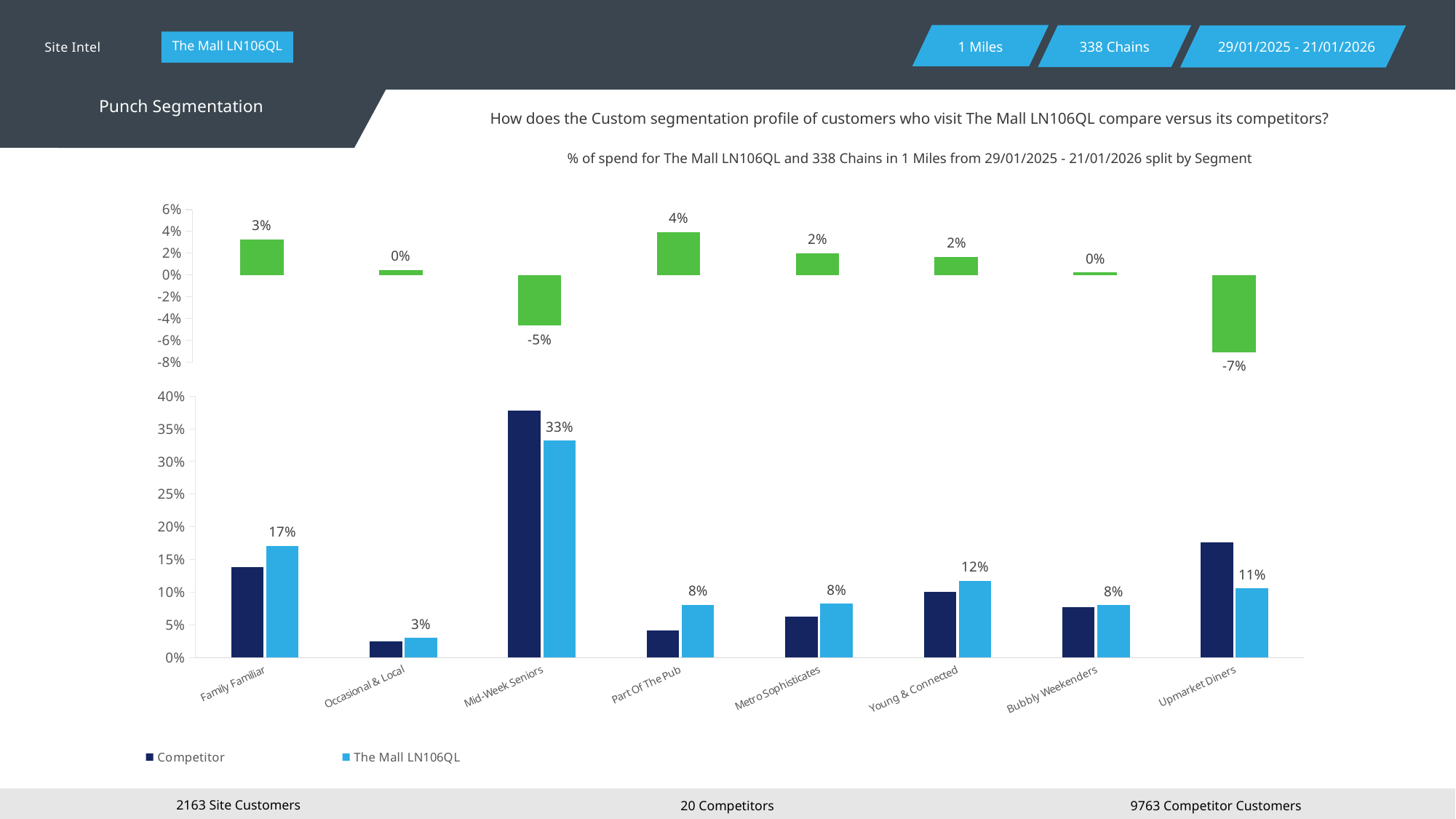
In the bottom chart, what is the difference between The Mall LN106QL values for Family Familiar and Occasional & Local? 14% What kind of chart is the bottom chart? Bar chart In the top chart, which segment has the lowest value? Upmarket Diners In the bottom chart, which segment has the highest value for The Mall LN106QL? Mid-Week Seniors How many segments are shown on the x axis of the bottom chart? 8 In the bottom chart, what is the value for The Mall LN106QL in the Young & Connected segment? 12% In the top chart, what is the value for Upmarket Diners? -7% In the bottom chart, what is the value for The Mall LN106QL in the Mid-Week Seniors segment? 33% In the bottom chart, is the Competitor value for Mid-Week Seniors greater or less than 35%? greater In the bottom chart, which segment has the lowest value for The Mall LN106QL? Occasional & Local In the bottom chart, for Upmarket Diners, which series has the larger value: Competitor or The Mall LN106QL? Competitor How many series does the legend of the bottom chart list? 2